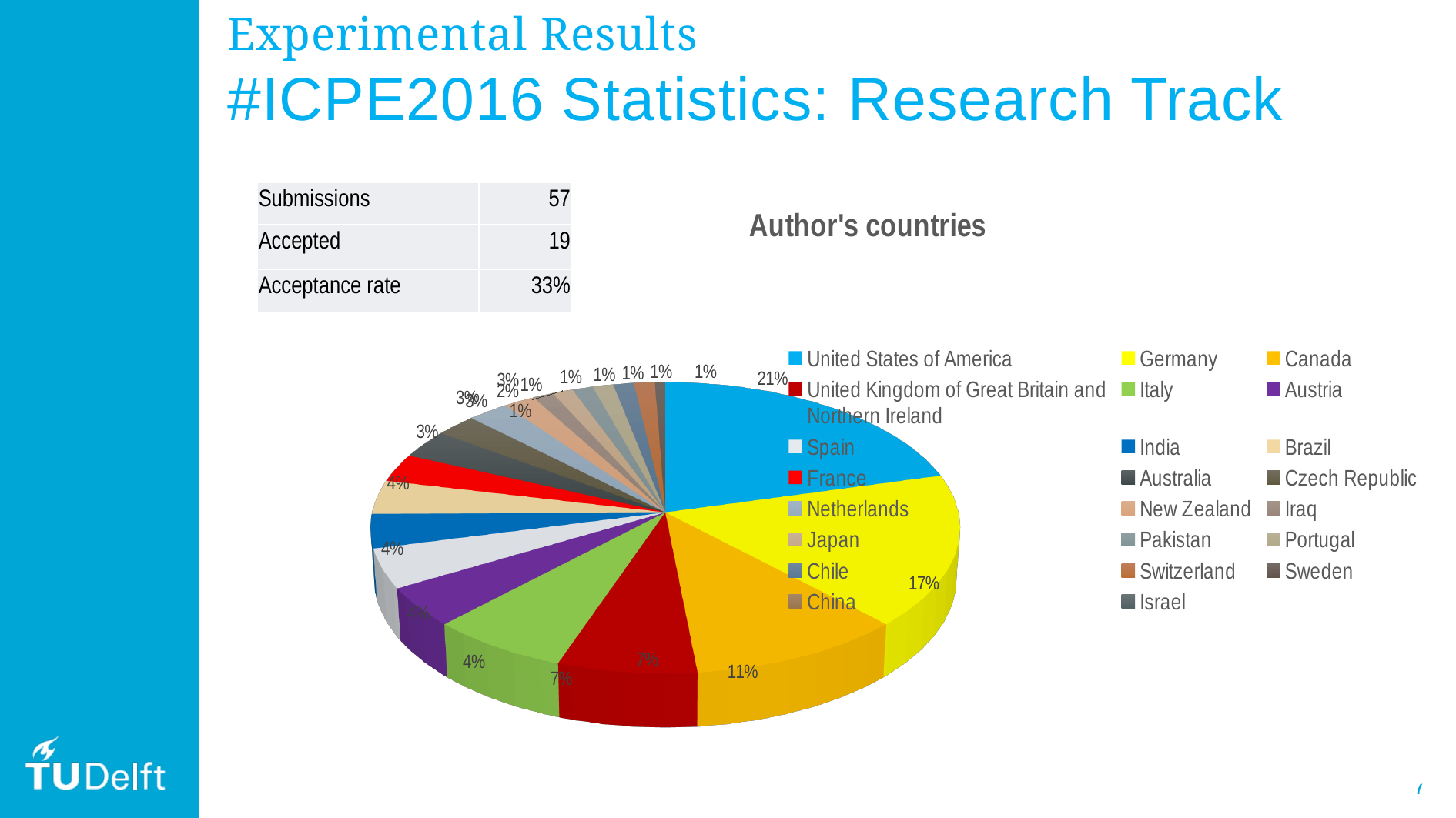
What is the title of the pie chart? Author's countries Which has the larger share, Canada or the United Kingdom of Great Britain and Northern Ireland? Canada What kind of chart is shown under the title "Author's countries"? pie chart Which country has the largest slice of the pie? United States of America What colour is the slice for the United States of America? blue What share of the pie does Canada have? 11% How many percentage points larger is the United States of America's share than Germany's? 4 How many countries are listed in the pie chart's legend? 23 What share of the pie does Germany have? 17% What share of the pie does the United Kingdom of Great Britain and Northern Ireland have? 7% Which has the larger share, Germany or Canada? Germany